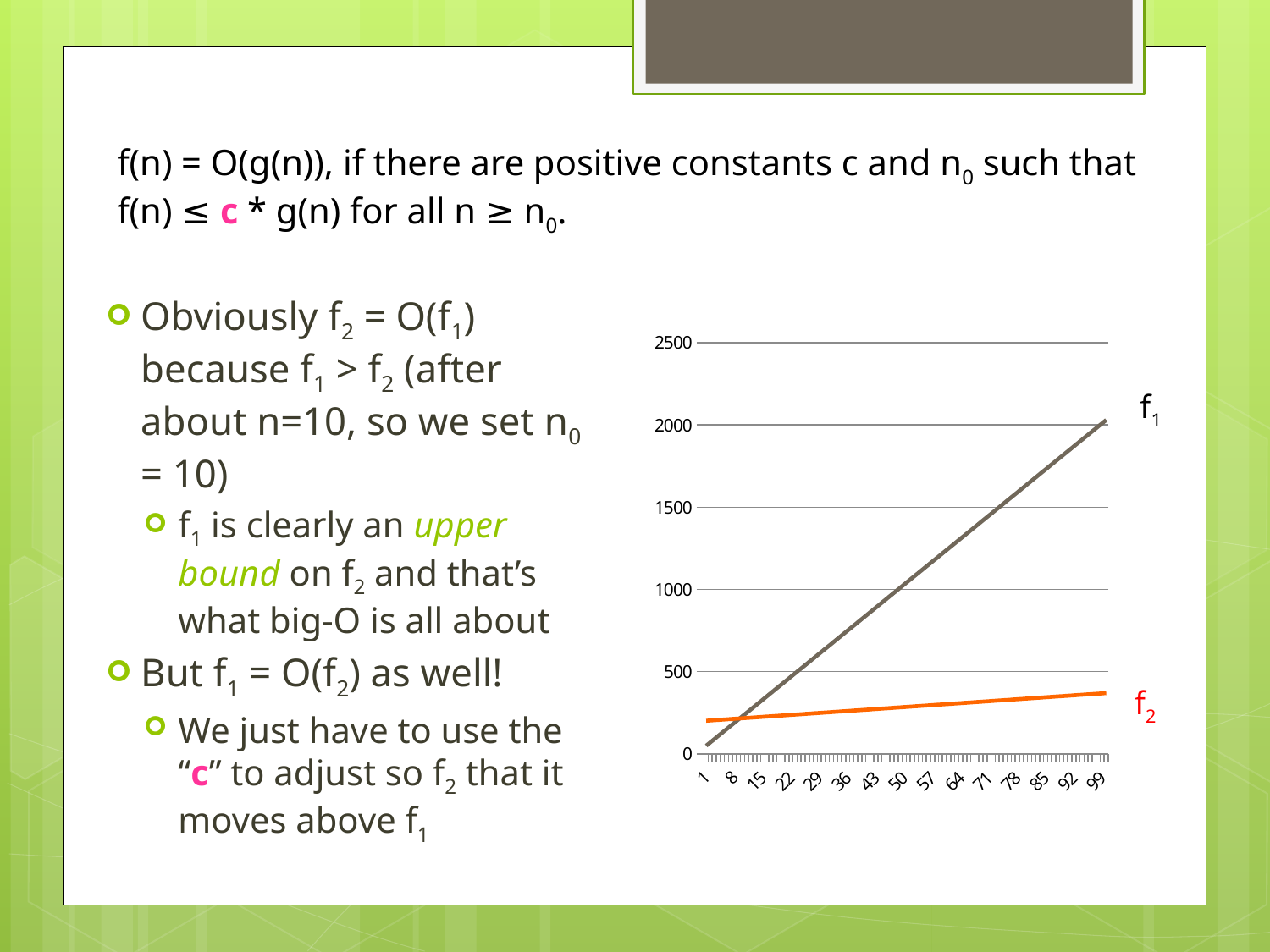
At n = 1, which series has the larger value, f1 or f2? f2 Is the value of f1 at n = 64 greater or less than 1000? greater What are the two series on the chart labelled? f1 and f2 Is the value of f1 at n = 1 greater or less than 500? less What is the highest value shown on the y axis? 2500 Does the f1 line rise or fall as n increases along the x axis? rise Is the value of f2 at n = 99 greater or less than 500? less Does the f2 line rise or fall as n increases along the x axis? rise What kind of chart is shown on the slide? line chart How many series are plotted on the chart? 2 At n = 99, which series has the larger value, f1 or f2? f1 How many labelled tick values are shown on the x axis? 15